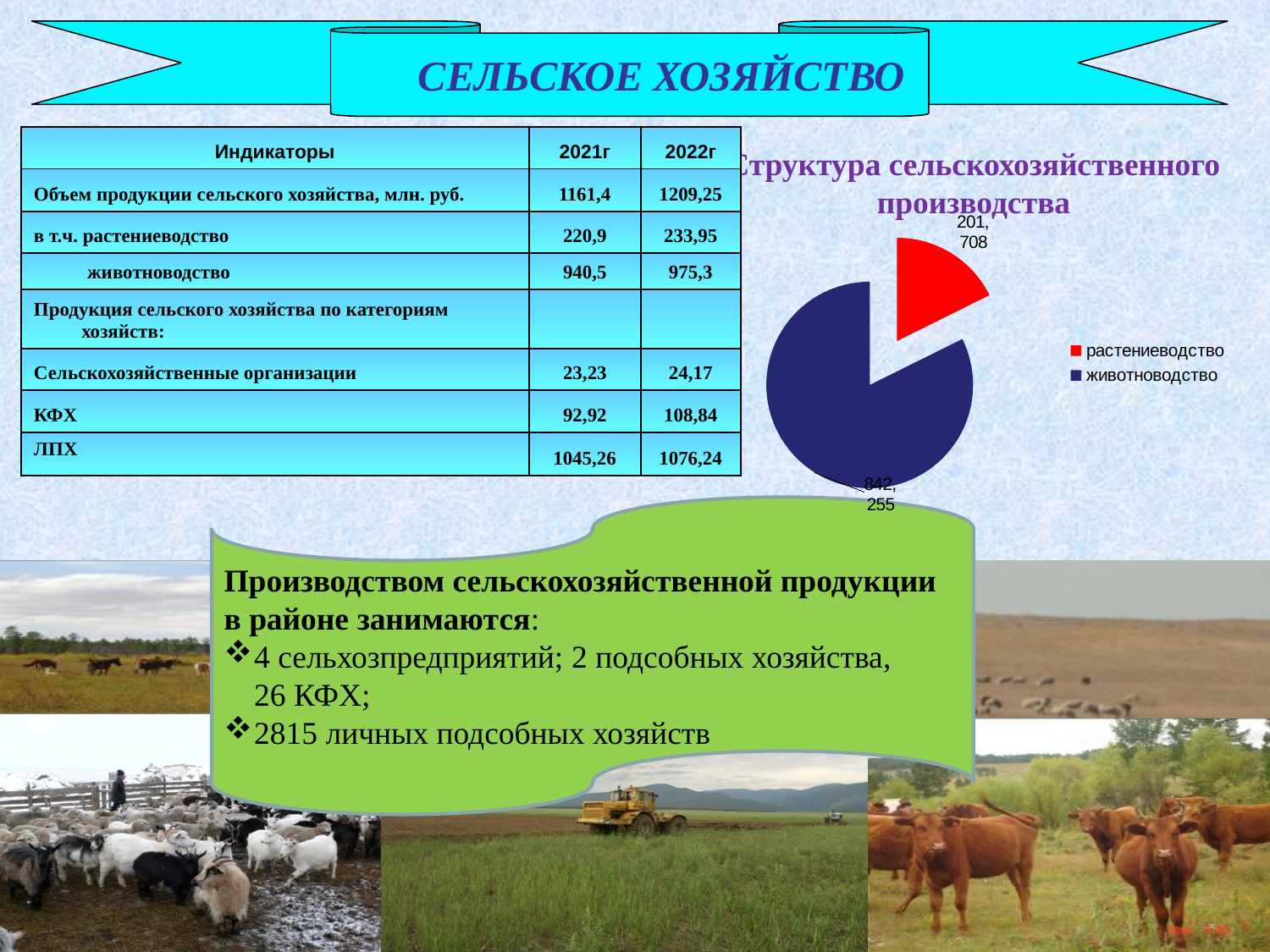
What is the title of the pie chart on the slide? Структура сельскохозяйственного производства In the pie chart, what value is shown for растениеводство? 201,708 Which slice of the pie chart is the largest? животноводство In the pie chart, which is larger: растениеводство or животноводство? животноводство What colour is the растениеводство slice in the pie chart? red What kind of chart is shown under the title "Структура сельскохозяйственного производства"? pie chart How many slices does the pie chart "Структура сельскохозяйственного производства" have? 2 How many entries does the legend of the pie chart list? 2 In the pie chart, what value is shown for животноводство? 842,255 What is the difference between the животноводство and растениеводство values in the pie chart? 640,547 Which slice of the pie chart is the smallest? растениеводство